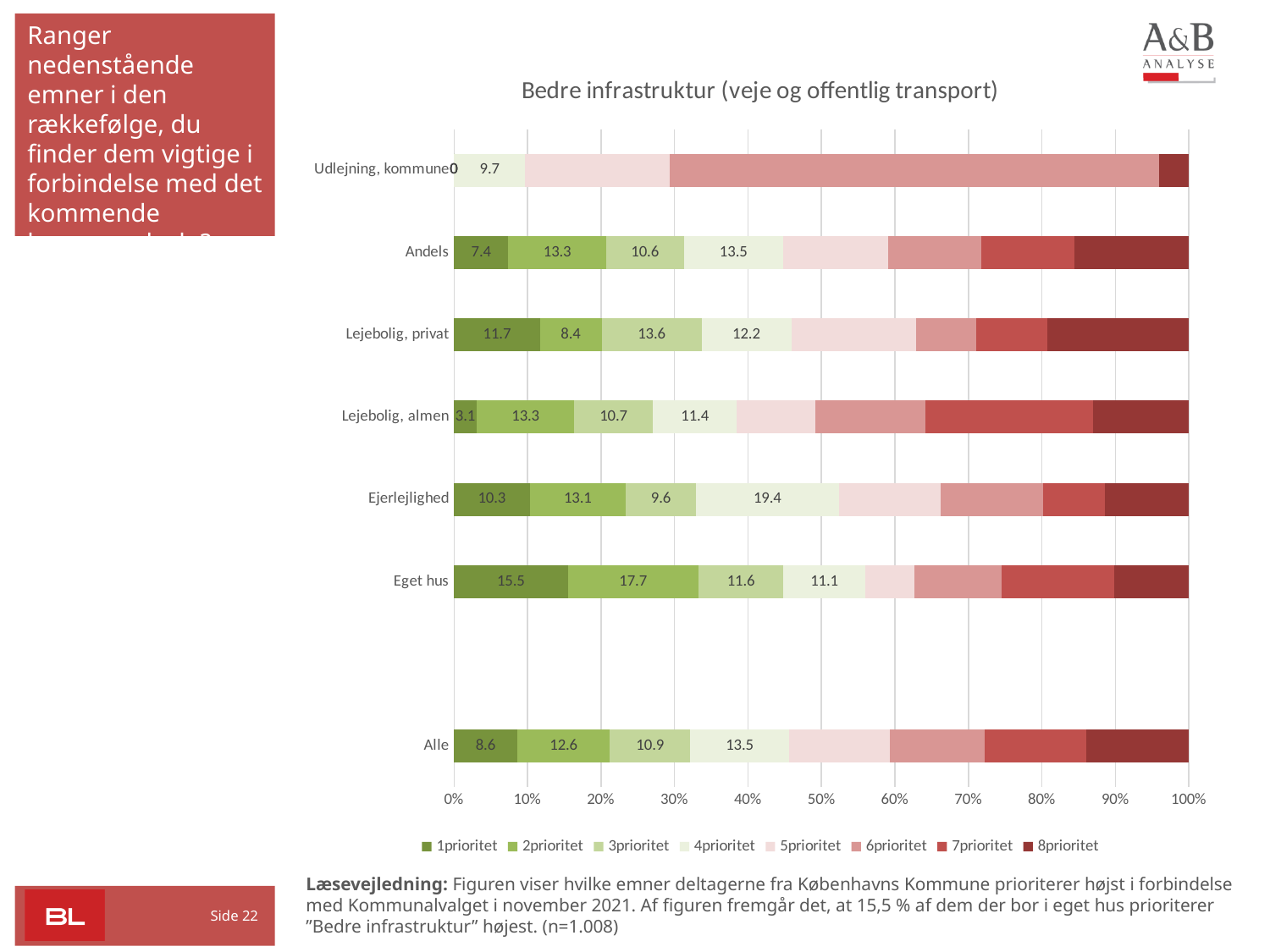
Which is larger: the 2prioritet value for Eget hus or the 2prioritet value for Andels? Eget hus What is the title of the chart? Bedre infrastruktur (veje og offentlig transport) What is the 4prioritet value for Ejerlejlighed? 19.4 How many series does the legend list? 8 What is the 2prioritet value for Udlejning, kommune? 0 What type of chart is shown on the slide? Stacked bar chart Which category has the highest 1prioritet value? Eget hus What is the difference between the 1prioritet value for Eget hus and the 1prioritet value for Alle? 6.9 How many categories are shown on the y axis of the chart? 7 What is the 3prioritet value for Lejebolig, privat? 13.6 Which category has the lowest 1prioritet value? Udlejning, kommune What is the 1prioritet value for Eget hus? 15.5